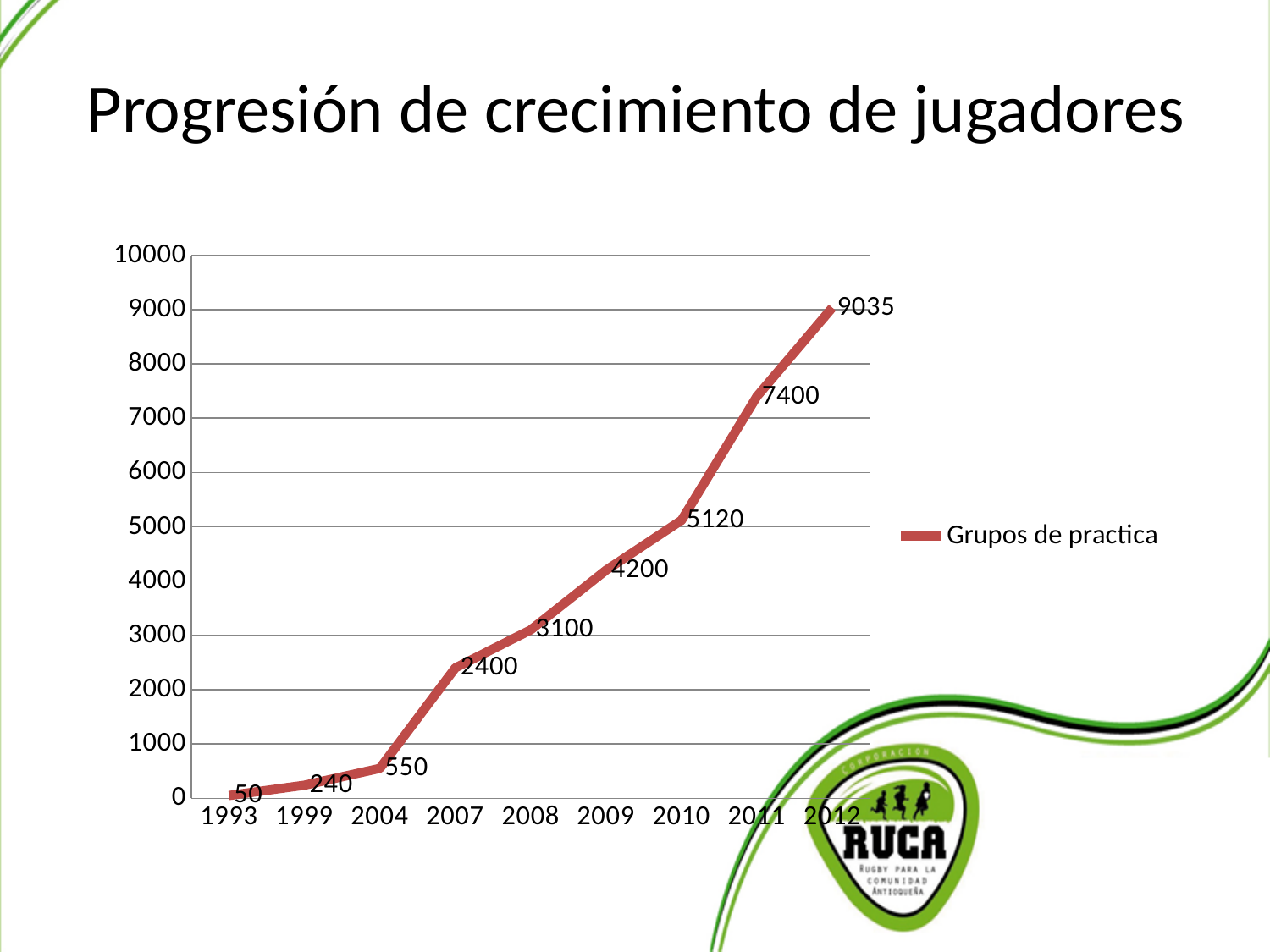
Which is larger, the value for 2008 or the value for 2009? 2009 How many series does the legend list? 1 What is the value for 2012? 9035 How many years are plotted on the x axis? 9 What is the difference between the values for 2011 and 2010? 2280 What kind of chart is shown? line chart Is the value for 2011 greater or less than 7000? greater Which year has the highest value? 2012 What is the value for 2007? 2400 What is the value for 1999? 240 Which year has the lowest value? 1993 Do the values rise or fall from 1993 to 2012? rise